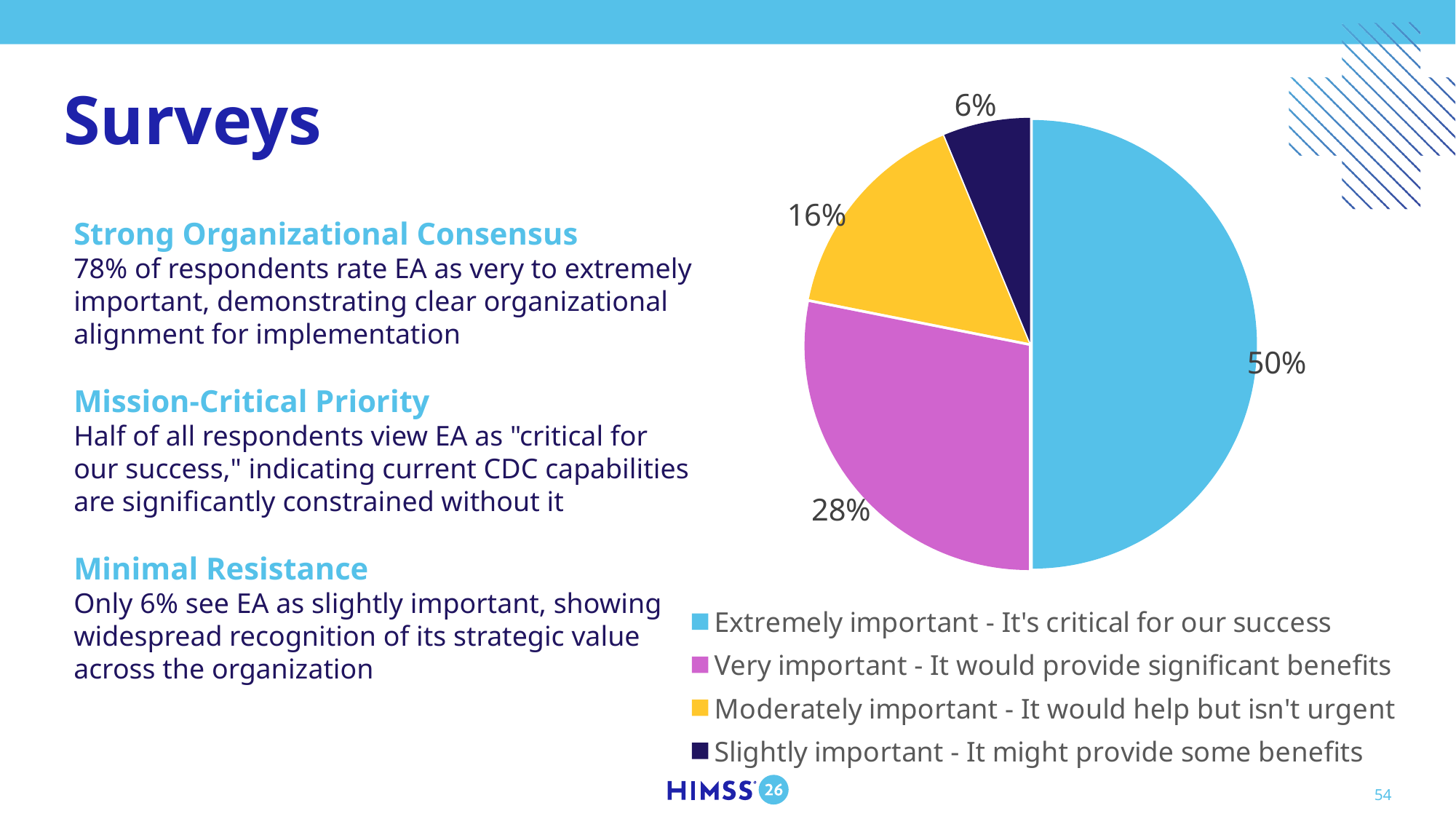
What kind of chart is shown on the slide? pie chart What colour is the 'Very important - It would provide significant benefits' slice? purple What share of the pie is labelled 'Moderately important - It would help but isn't urgent'? 16% What share of the pie is labelled 'Slightly important - It might provide some benefits'? 6% Which slice is larger: 'Moderately important' or 'Slightly important'? Moderately important - It would help but isn't urgent Which category has the largest slice of the pie? Extremely important - It's critical for our success What is the difference in percentage points between the 'Extremely important' slice and the 'Very important' slice? 22 What is the combined share of the 'Extremely important' and 'Very important' slices? 78% Which category has the smallest slice of the pie? Slightly important - It might provide some benefits What share of the pie is labelled 'Very important - It would provide significant benefits'? 28% What share of the pie is labelled 'Extremely important - It's critical for our success'? 50% How many slices does the pie chart have? 4